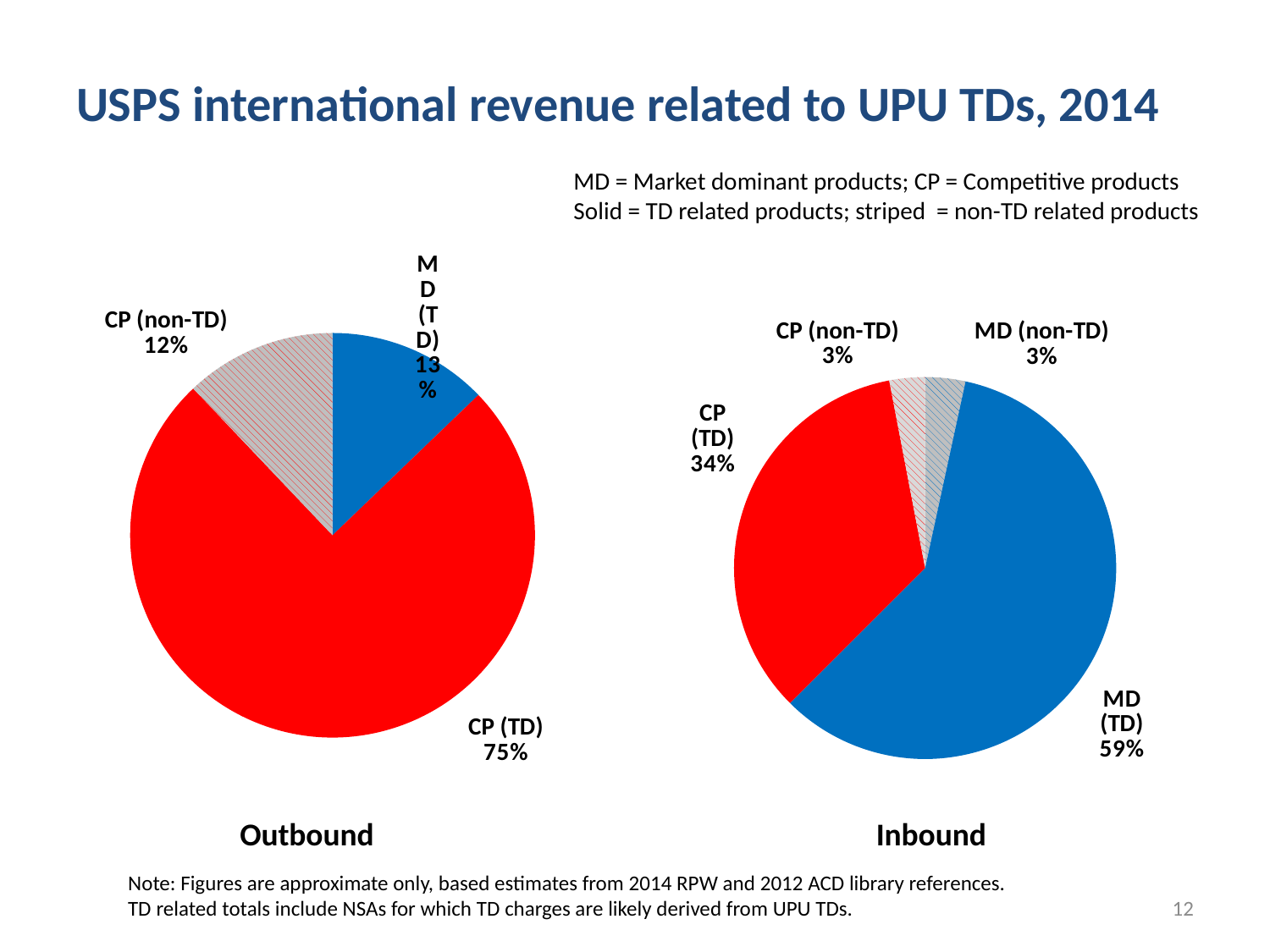
In the Inbound chart, what share does CP (non-TD) have? 3% In the Inbound chart, what is the difference between the MD (TD) share and the CP (TD) share? 25% What type of chart is the Outbound chart? Pie chart In the Inbound chart, what share does MD (TD) have? 59% In the Inbound chart, what share does CP (TD) have? 34% In the Outbound chart, what share does CP (TD) have? 75% In the Outbound chart, which category has the smallest share? CP (non-TD) In the Inbound chart, which category has the largest share? MD (TD) In the Outbound chart, which category has the largest share? CP (TD) In the Outbound chart, which is larger, MD (TD) or CP (non-TD)? MD (TD) In the Outbound chart, what share does MD (TD) have? 13% How many slices are labelled in the Inbound chart? 4